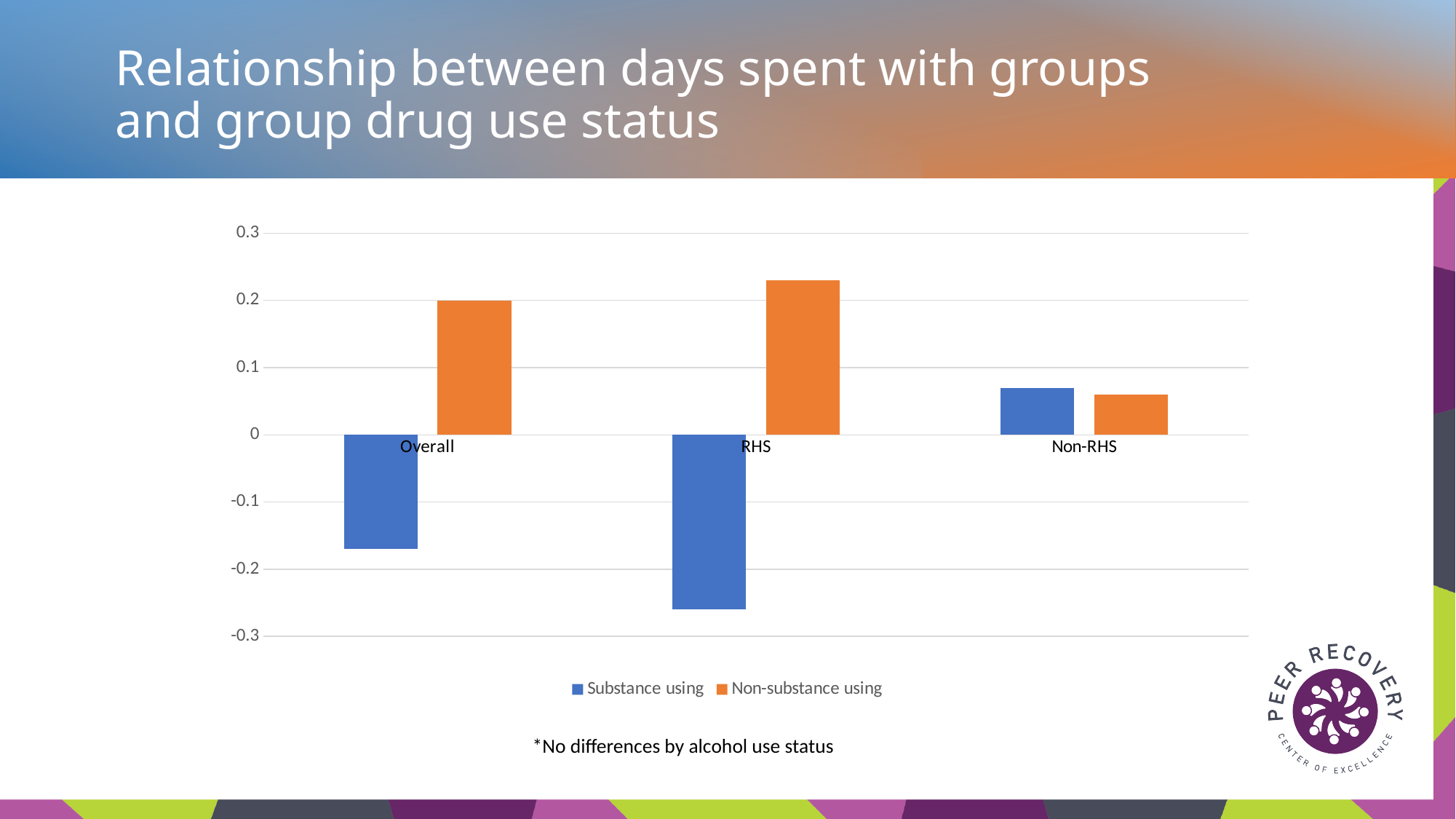
How many series does the chart's legend list? 2 Is the Substance using value for Non-RHS greater or less than 0.1? less Which category has the highest Non-substance using value? RHS Which category has the lowest Substance using value? RHS Is the Non-substance using value for RHS greater or less than 0.2? greater Which is larger: the Non-substance using value for Overall or for Non-RHS? Overall Is the Substance using value for Overall greater or less than -0.1? less How many categories are shown on the x axis of the chart? 3 Which colour represents the Substance using series in the chart? blue What footnote appears below the chart's legend? *No differences by alcohol use status What kind of chart is shown on the slide? bar chart